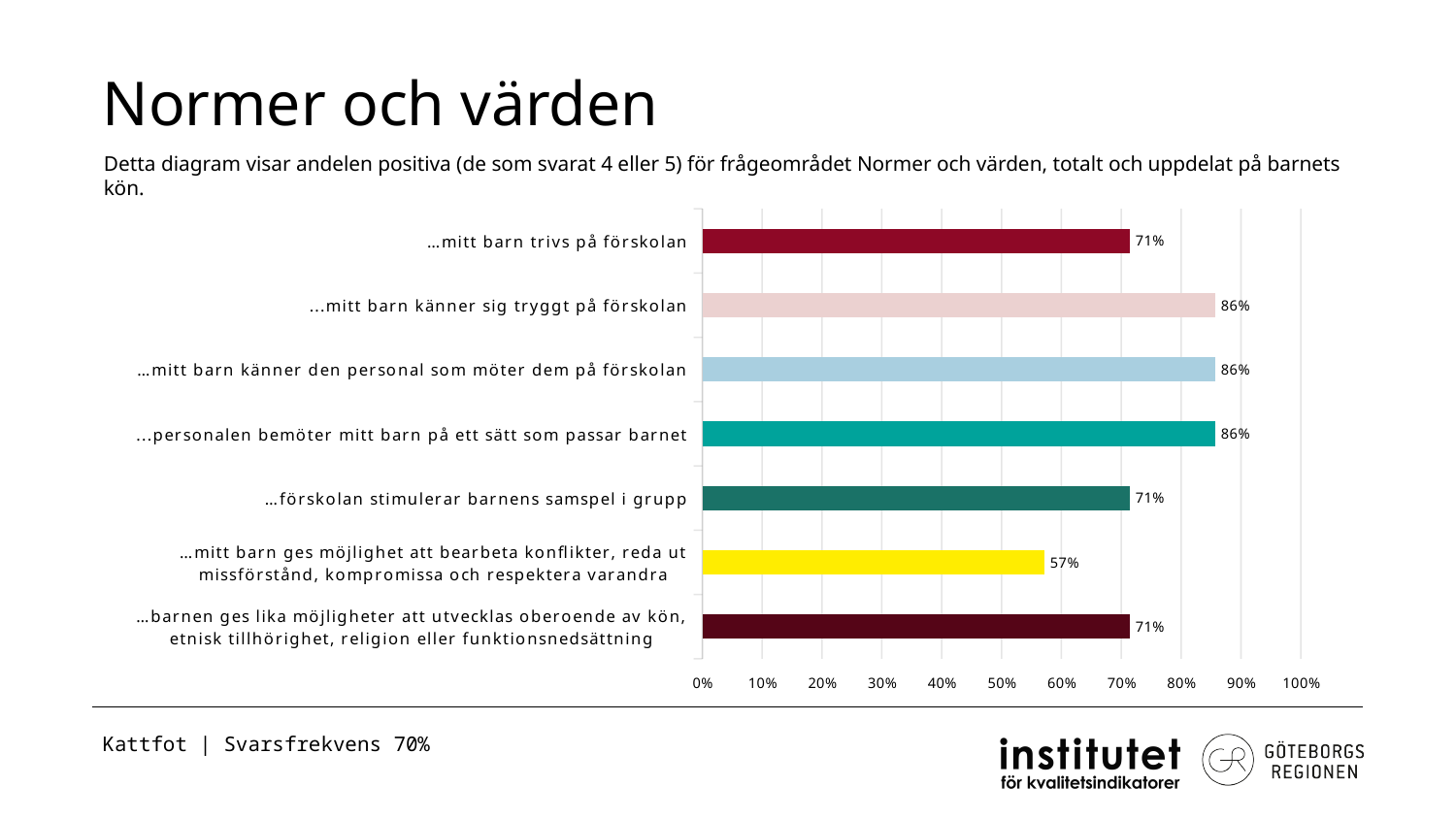
What is the title of the slide containing the chart? Normer och värden What is the value for "...mitt barn känner sig tryggt på förskolan"? 86% Which is larger: the value for "…mitt barn känner den personal som möter dem på förskolan" or the value for "…barnen ges lika möjligheter att utvecklas oberoende av kön, etnisk tillhörighet, religion eller funktionsnedsättning"? …mitt barn känner den personal som möter dem på förskolan What is the value for "…förskolan stimulerar barnens samspel i grupp"? 71% What kind of chart is shown on the slide? Bar chart Which category has the lowest value? …mitt barn ges möjlighet att bearbeta konflikter, reda ut missförstånd, kompromissa och respektera varandra What is the difference between the value for "...personalen bemöter mitt barn på ett sätt som passar barnet" and the value for "…mitt barn ges möjlighet att bearbeta konflikter, reda ut missförstånd, kompromissa och respektera varandra"? 29 percentage points What is the value for "…mitt barn trivs på förskolan"? 71% What is the value for "…mitt barn ges möjlighet att bearbeta konflikter, reda ut missförstånd, kompromissa och respektera varandra"? 57% Is the value for "…mitt barn trivs på förskolan" greater or less than 80%? less How many categories have a value of 86%? 3 How many categories are shown in the chart? 7